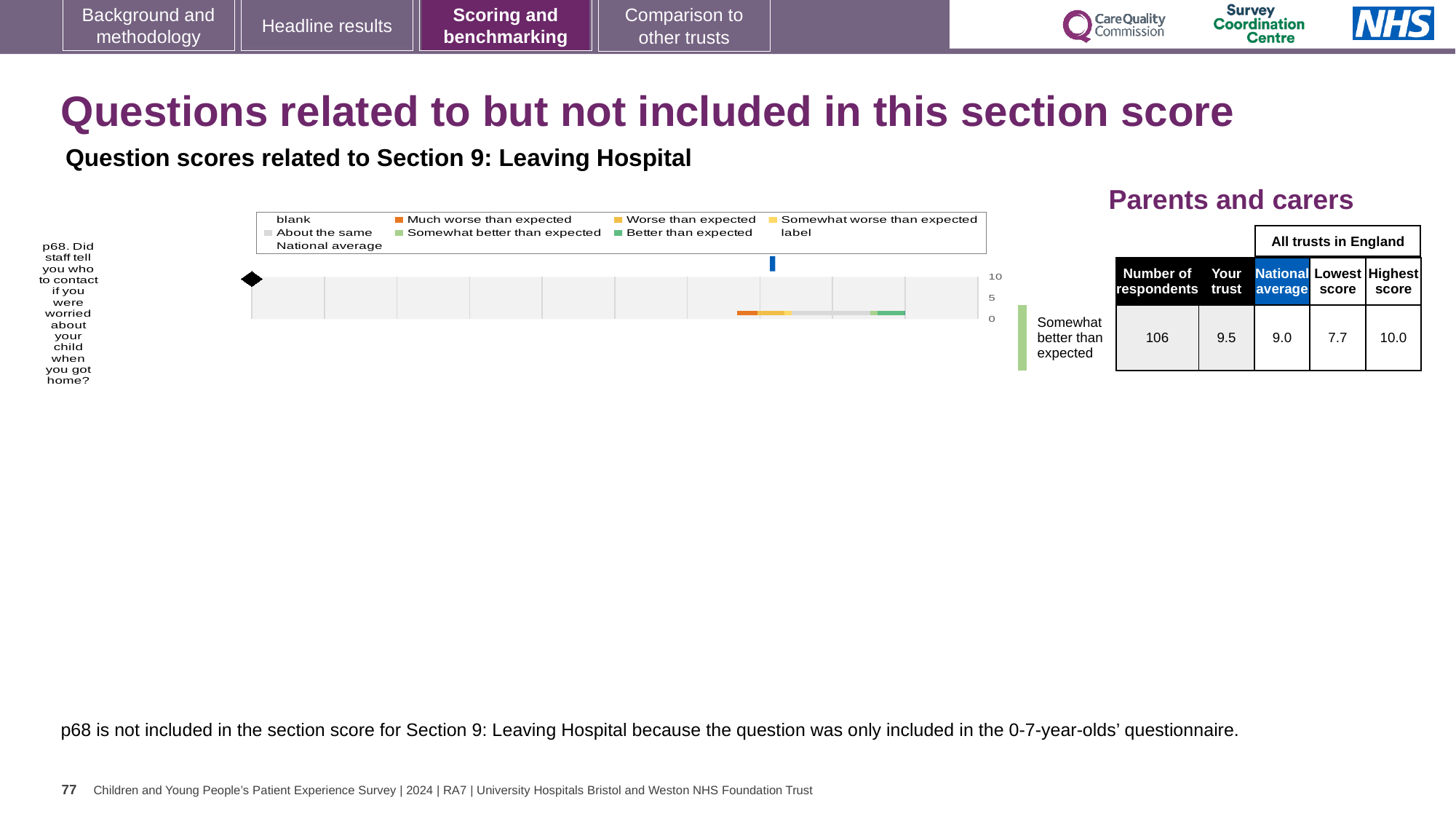
According to the table, what is the national average score for p68? 9.0 According to the table, what is the 'Your trust' score for p68? 9.5 According to the table, what is the highest score among all trusts in England for p68? 10.0 What is the difference between the 'Your trust' score and the national average for p68? 0.5 Which question number is plotted in the chart? p68 According to the table, what is the lowest score among all trusts in England for p68? 7.7 What is the highest value shown on the chart's axis? 10 How many survey questions are plotted in the chart? 1 What kind of chart is shown on the slide? bar chart Which is larger for p68: the 'Your trust' score or the national average? Your trust How many respondents answered p68 according to the table? 106 What is the difference between the highest and lowest scores among all trusts in England for p68? 2.3